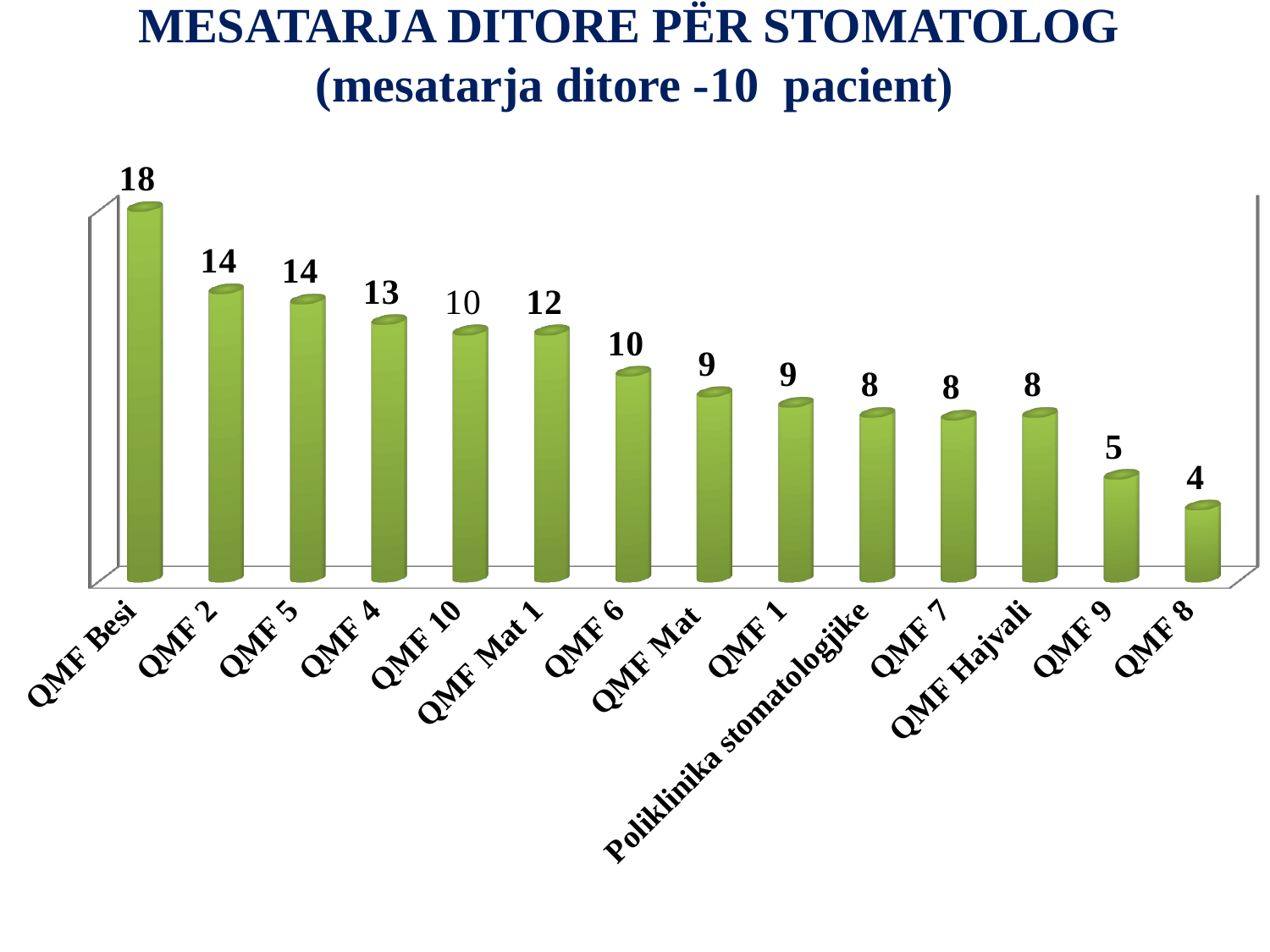
Do the values generally rise or fall from left to right along the x axis? Fall What is the value for QMF Besi? 18 Which category has the lowest value? QMF 8 What is the value for QMF 9? 5 What is the value for QMF Mat 1? 12 What is the difference between the values for QMF Besi and QMF 8? 14 Which is larger, the value for QMF 2 or the value for QMF Mat? QMF 2 What is the difference between the values for QMF 4 and QMF 6? 3 How many categories are shown in the chart? 14 What is the value for QMF Hajvali? 8 Which category has the highest value? QMF Besi What kind of chart is shown on the slide? Bar chart